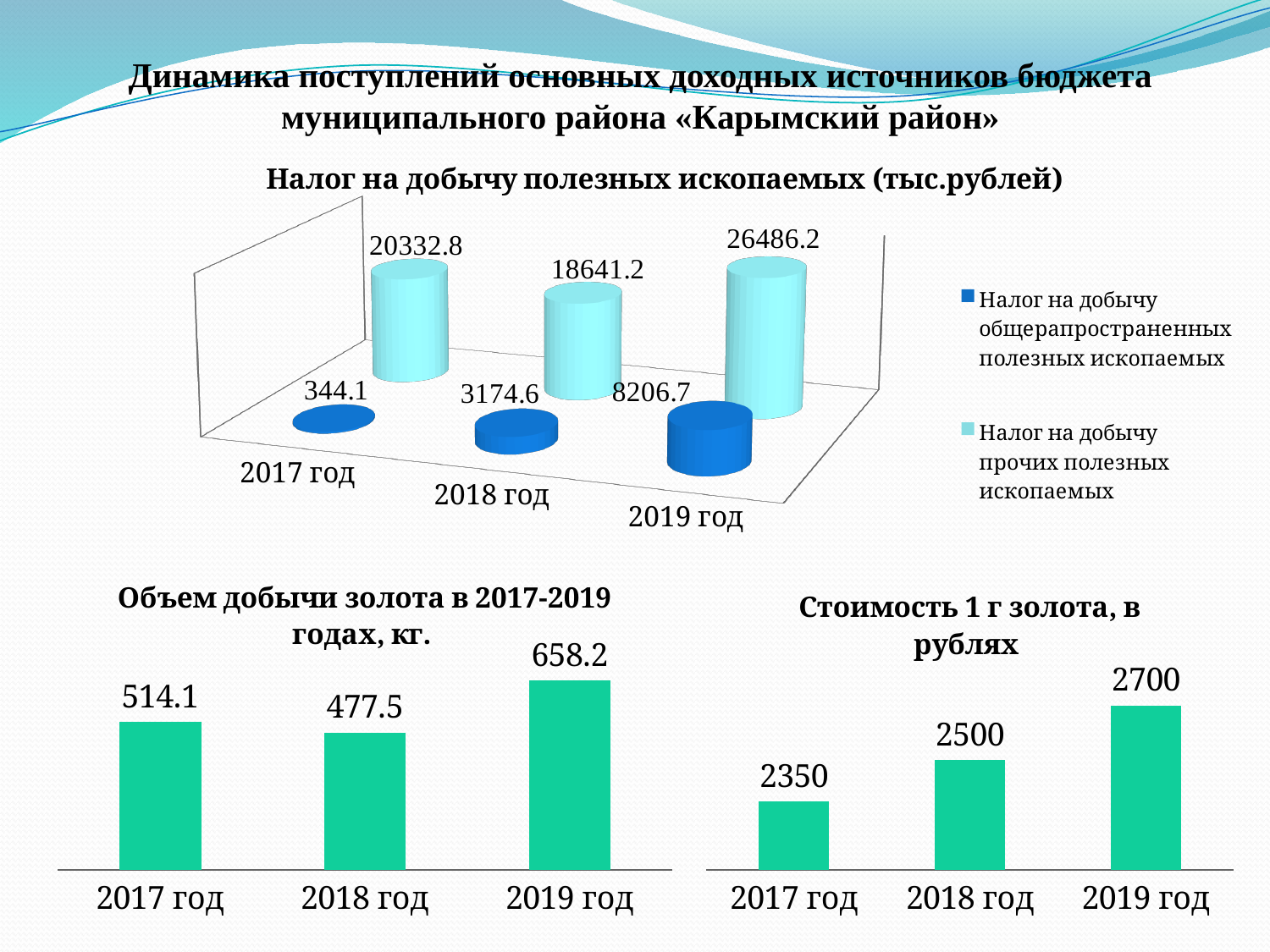
In the chart "Налог на добычу полезных ископаемых (тыс.рублей)", how many series does the legend list? 2 In the chart "Объем добычи золота в 2017-2019 годах, кг.", which year has the highest value? 2019 год In the chart "Налог на добычу полезных ископаемых (тыс.рублей)", what is the value for "Налог на добычу общерапространенных полезных ископаемых" in 2017 год? 344.1 In the chart "Стоимость 1 г золота, в рублях", what is the value for 2017 год? 2350 In the chart "Объем добычи золота в 2017-2019 годах, кг.", what is the value for 2018 год? 477.5 In the chart "Стоимость 1 г золота, в рублях", do the values rise or fall from 2017 год to 2019 год? rise In the chart "Объем добычи золота в 2017-2019 годах, кг.", which is larger, the value for 2017 год or 2018 год? 2017 год In the chart "Стоимость 1 г золота, в рублях", what is the difference between the 2019 год and 2017 год values? 350 In the chart "Налог на добычу полезных ископаемых (тыс.рублей)", what is the difference between the 2019 год and 2018 год values for "Налог на добычу общерапространенных полезных ископаемых"? 5032.1 What kind of chart is "Стоимость 1 г золота, в рублях"? bar chart In the chart "Налог на добычу полезных ископаемых (тыс.рублей)", what is the value for "Налог на добычу прочих полезных ископаемых" in 2019 год? 26486.2 In the chart "Налог на добычу полезных ископаемых (тыс.рублей)", which year has the lowest value for "Налог на добычу прочих полезных ископаемых"? 2018 год